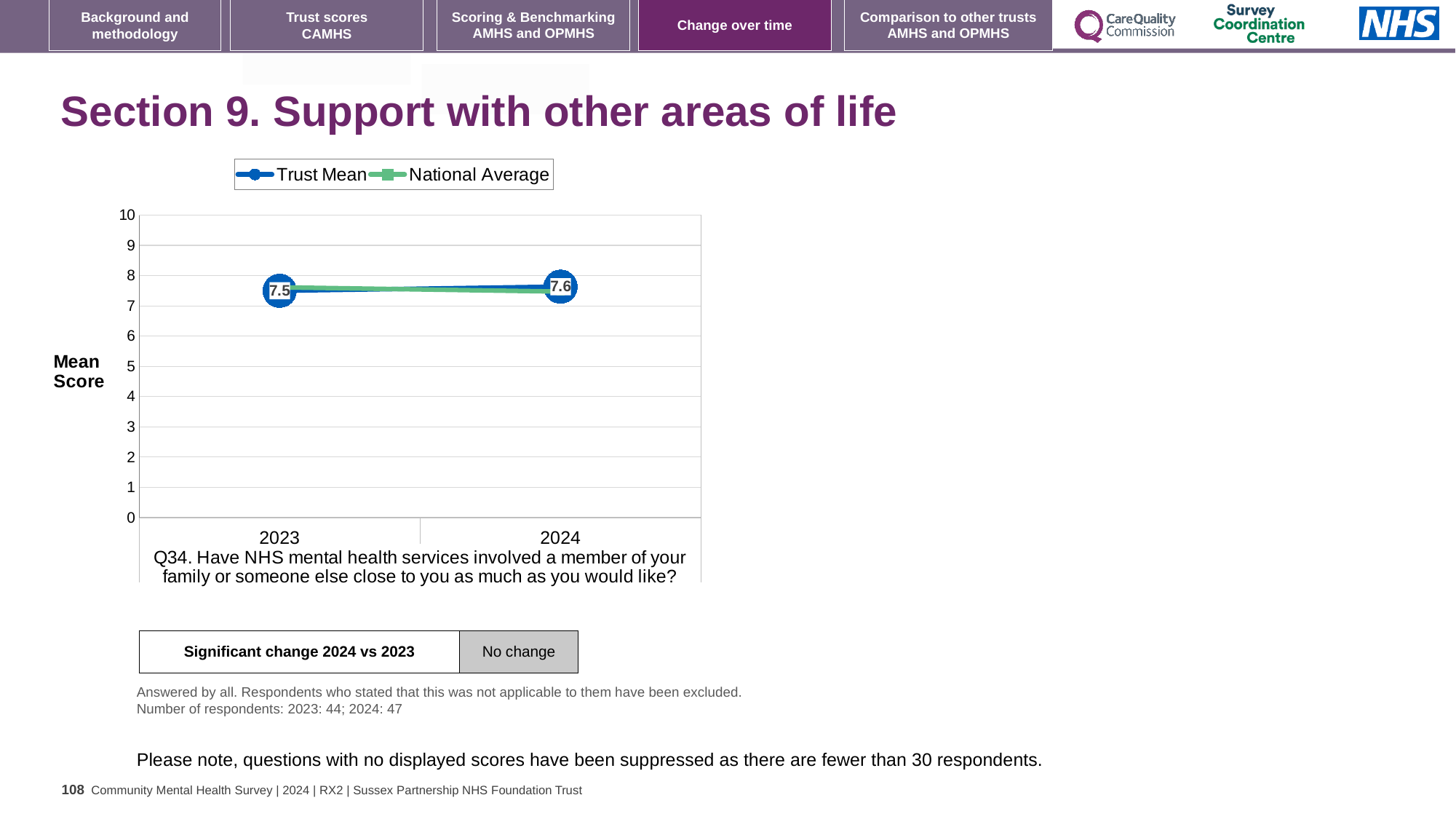
Is the Trust Mean value for 2023 greater or less than 9? less How many years are shown on the x axis of the chart? 2 Which year has the higher Trust Mean, 2023 or 2024? 2024 By how much did the Trust Mean change from 2023 to 2024? 0.1 What is the label on the y axis of the chart? Mean Score What are the two series named in the chart legend? Trust Mean and National Average What kind of chart is shown on the slide? line chart Does the Trust Mean rise or fall from 2023 to 2024? rise How many series does the chart legend list? 2 What is the Trust Mean for 2024? 7.6 What is the Trust Mean for 2023? 7.5 Is the National Average value for 2024 greater or less than 5? greater